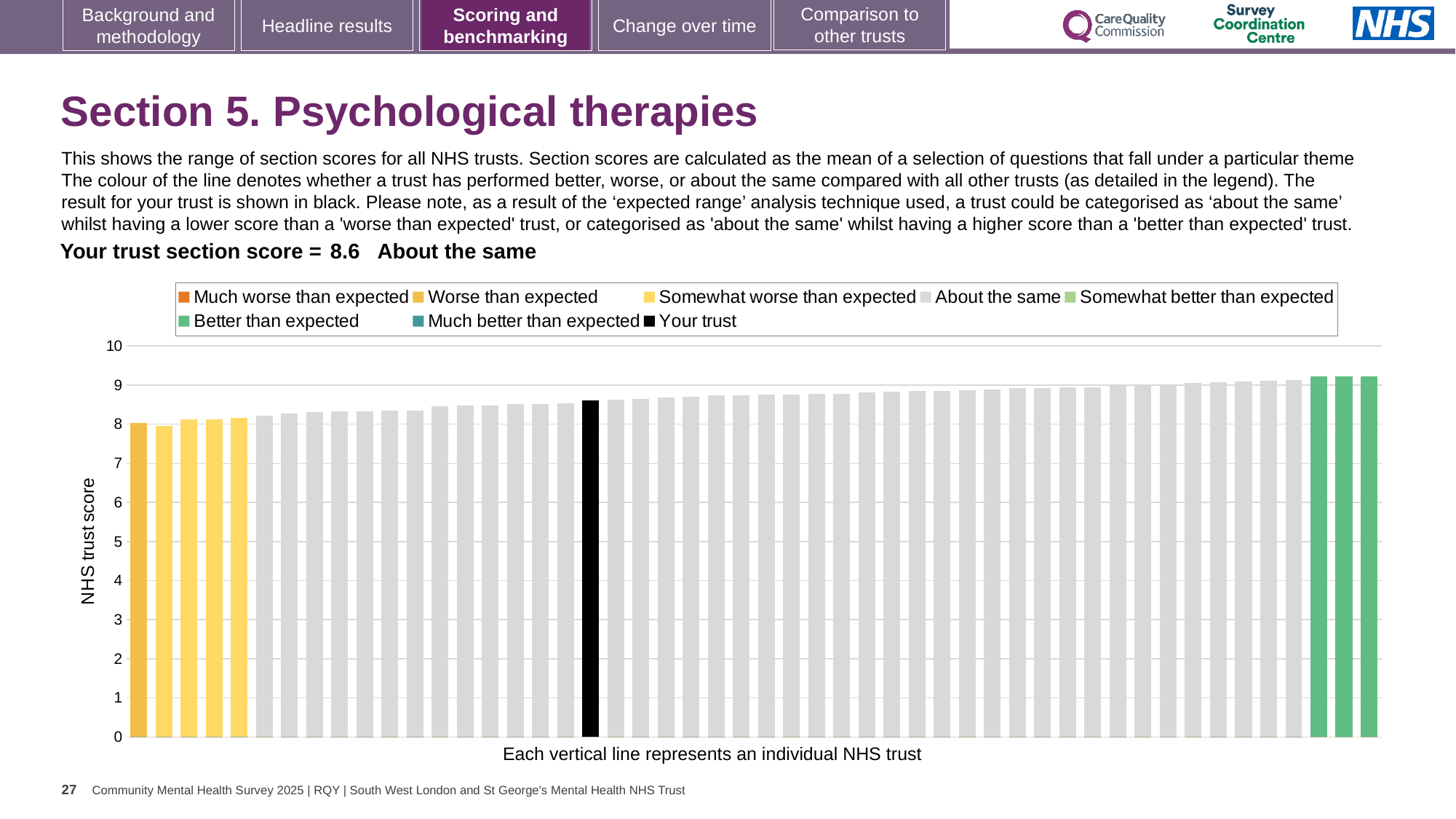
Is the value for your trust greater or less than 8? greater Which is larger: the score for your trust or the score of the leftmost bar? your trust What colour is the bar representing your trust? black What is the section score for your trust? 8.6 What is the title of the vertical axis? NHS trust score How many bars are coloured green (Better than expected)? 3 Are the values of the three green bars at the right end greater or less than 9? greater How many entries does the legend list? 8 What kind of chart is shown on the slide? bar chart Do the bar values rise or fall from left to right along the x axis? rise Which category is your trust placed in for this section? About the same Which legend category do the highest-scoring trusts belong to? Better than expected